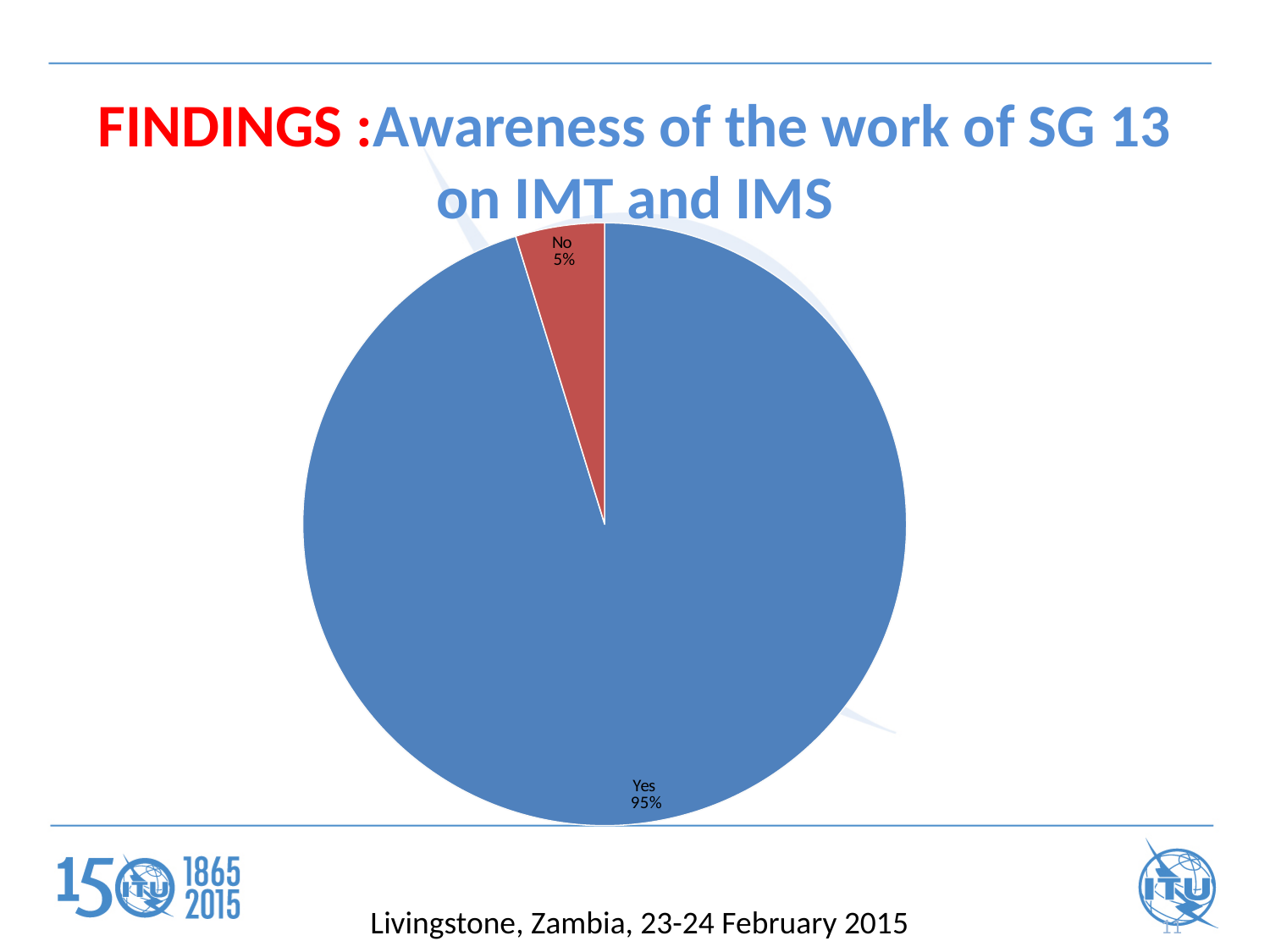
How many slices does the pie chart have? 2 What share of the pie does the "Yes" slice represent? 95% Which is larger, the "Yes" slice or the "No" slice? Yes What share of the pie does the "No" slice represent? 5% What colour is the "No" slice of the pie? red What kind of chart is shown on the slide? pie chart What is the difference in percentage points between the "Yes" and "No" slices? 90 What is the total of the two slice percentages shown on the pie chart? 100% What colour is the "Yes" slice of the pie? blue Which slice of the pie is the largest? Yes Which slice of the pie is the smallest? No